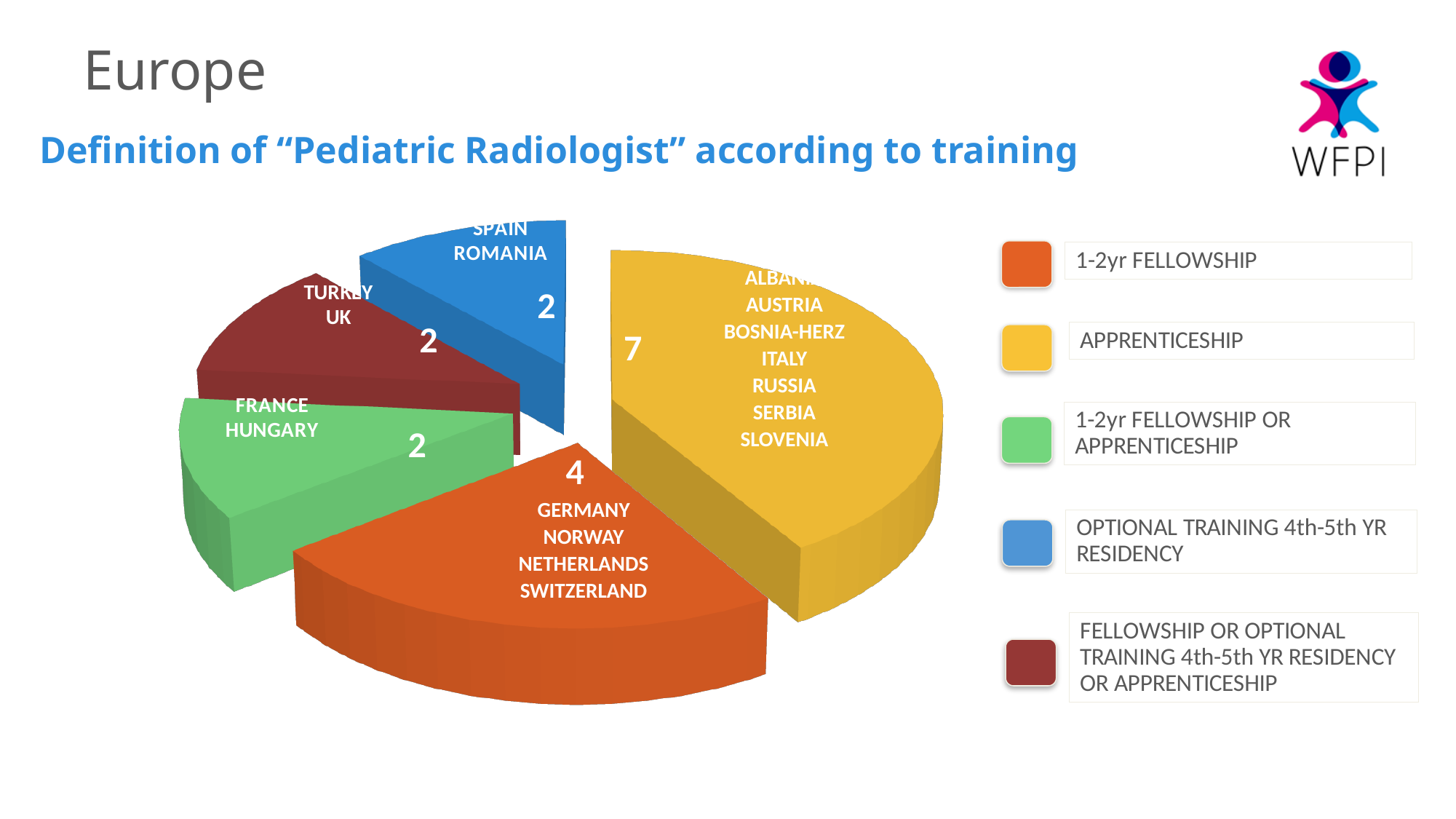
What is the value of the 1-2yr FELLOWSHIP slice? 4 How many slices have a value of 2? 3 How many entries does the legend list? 5 What is the total of all slice values in the pie chart? 17 What kind of chart is shown on the slide? Pie chart What is the value of the APPRENTICESHIP slice? 7 Which training category has the largest slice? APPRENTICESHIP How many slices does the pie chart have? 5 Which is larger, the 1-2yr FELLOWSHIP slice or the OPTIONAL TRAINING 4th-5th YR RESIDENCY slice? 1-2yr FELLOWSHIP What is the value of the slice containing FRANCE and HUNGARY? 2 Which colour represents APPRENTICESHIP in the legend? Yellow What is the difference between the APPRENTICESHIP slice and the 1-2yr FELLOWSHIP slice? 3